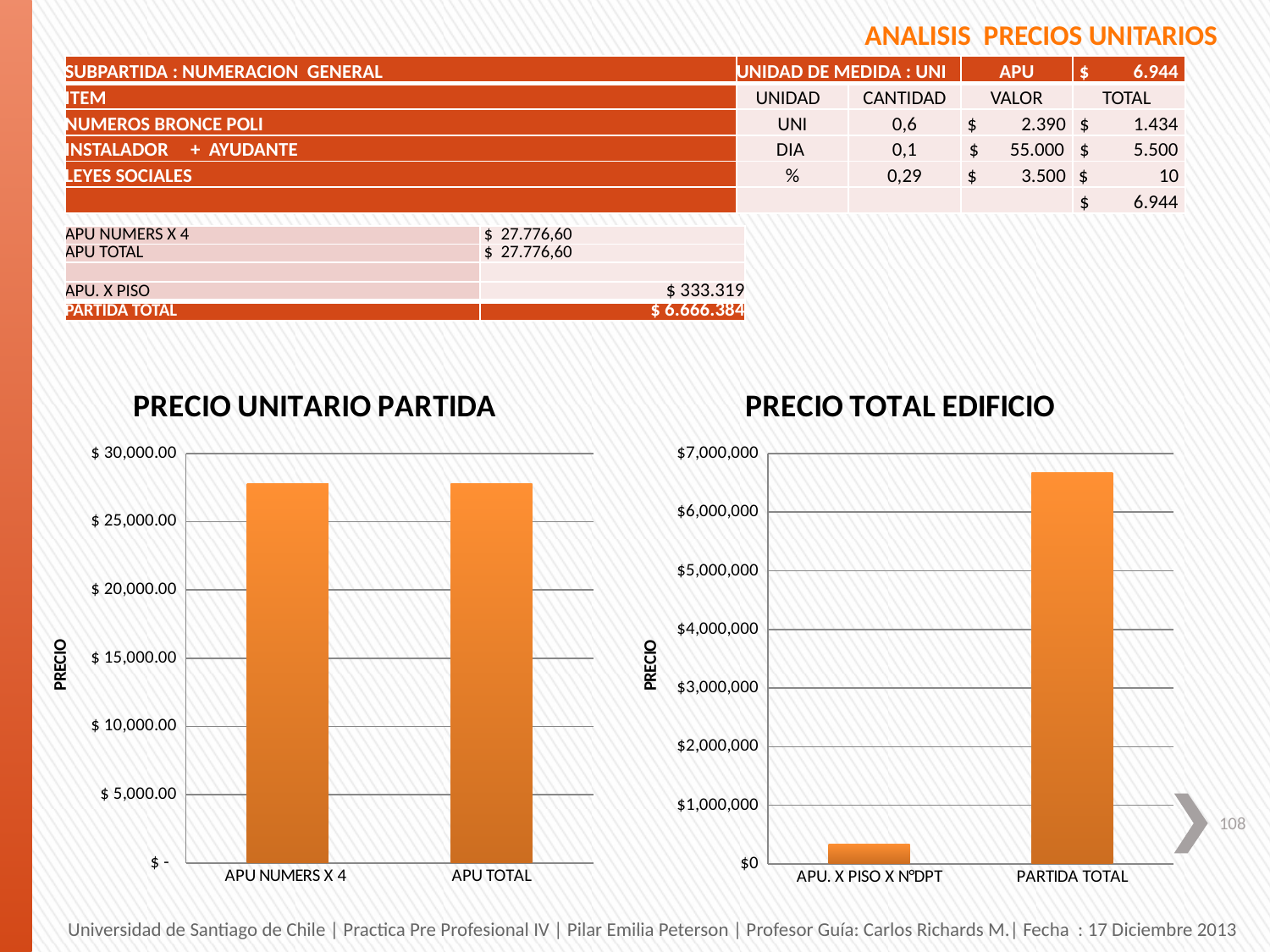
In the 'PRECIO UNITARIO PARTIDA' chart, is the value for APU NUMERS X 4 greater or less than $30,000.00? less What is the label on the vertical axis of the 'PRECIO UNITARIO PARTIDA' chart? PRECIO What kind of chart is the 'PRECIO TOTAL EDIFICIO' chart? bar chart In the 'PRECIO TOTAL EDIFICIO' chart, which category has the lowest value? APU. X PISO X N°DPT In the 'PRECIO TOTAL EDIFICIO' chart, is the value for APU. X PISO X N°DPT greater or less than $1,000,000? less What kind of chart is the 'PRECIO UNITARIO PARTIDA' chart? bar chart In the 'PRECIO UNITARIO PARTIDA' chart, is the value for APU TOTAL greater or less than $25,000.00? greater How many bars are plotted in the 'PRECIO TOTAL EDIFICIO' chart? 2 In the 'PRECIO TOTAL EDIFICIO' chart, which category has the highest value? PARTIDA TOTAL In the 'PRECIO TOTAL EDIFICIO' chart, which is larger: the value for PARTIDA TOTAL or the value for APU. X PISO X N°DPT? PARTIDA TOTAL How many categories are shown on the x axis of the 'PRECIO UNITARIO PARTIDA' chart? 2